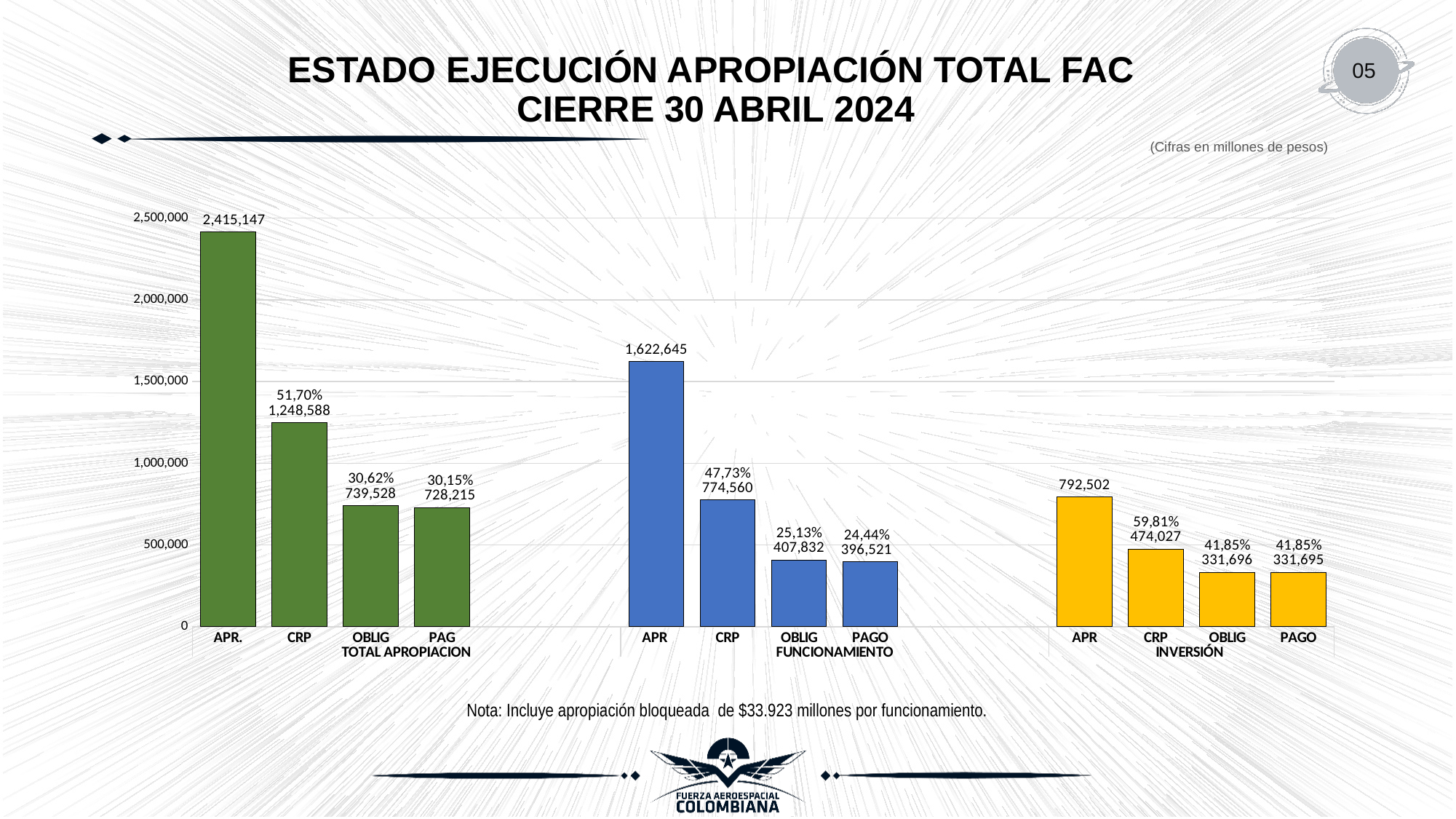
What colour are the bars in the INVERSIÓN group? Yellow What is the difference between the APR and CRP values in the INVERSIÓN group? 318,475 What is the value of the PAGO bar in the INVERSIÓN group? 331,695 Which bar is the highest in the whole chart? APR. (TOTAL APROPIACION) What is the difference between the OBLIG and PAGO values in the FUNCIONAMIENTO group? 11,311 What percentage is shown above the CRP bar in the INVERSIÓN group? 59,81% What kind of chart is shown on the slide? Bar chart What is the value of the CRP bar in the FUNCIONAMIENTO group? 774,560 Which is larger: the CRP bar in TOTAL APROPIACION or the APR bar in FUNCIONAMIENTO? APR in FUNCIONAMIENTO Which bar is the lowest within the FUNCIONAMIENTO group? PAGO What is the value of the APR. bar in the TOTAL APROPIACION group? 2,415,147 How many bars are plotted in the chart in total? 12